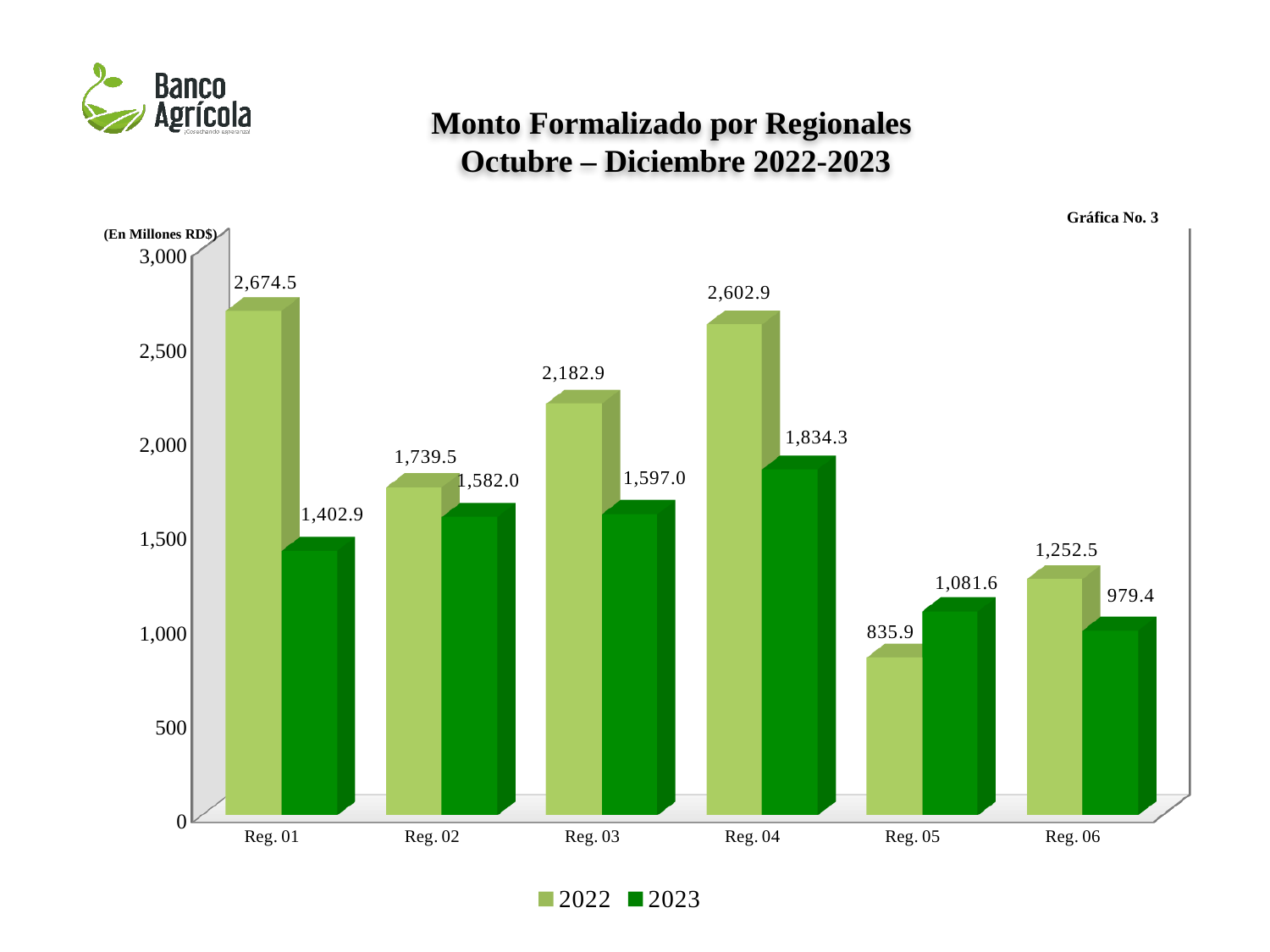
Which region has the lowest value in the 2023 series? Reg. 06 What is the value for Reg. 04 in the 2023 series? 1,834.3 What is the difference between the 2023 and 2022 values for Reg. 05? 245.7 What is the value for Reg. 05 in the 2022 series? 835.9 How many regions are shown on the x axis? 6 Which region has the highest value in the 2022 series? Reg. 01 What is the value for Reg. 01 in the 2022 series? 2,674.5 What is the difference between the 2022 and 2023 values for Reg. 01? 1,271.6 Which region has the highest value in the 2023 series? Reg. 04 What kind of chart is shown on the slide? Bar chart How many series does the legend list? 2 For Reg. 05, which series has the larger value, 2022 or 2023? 2023